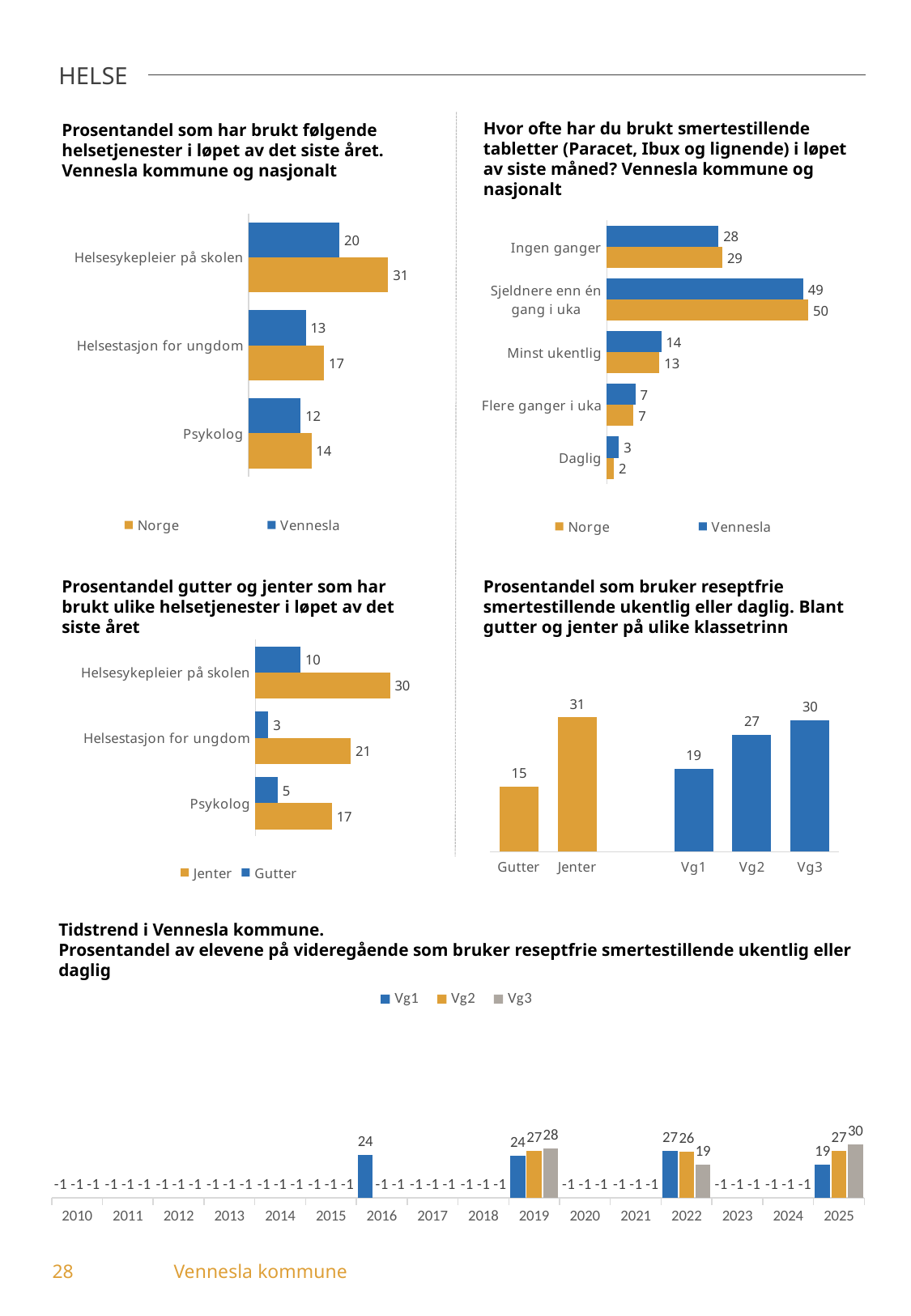
In the chart 'Prosentandel gutter og jenter som har brukt ulike helsetjenester', what is the value for Gutter for Helsestasjon for ungdom? 3 In the chart 'Prosentandel som har brukt følgende helsetjenester i løpet av det siste året', what is the value for Norge for Helsesykepleier på skolen? 31 In the chart 'Hvor ofte har du brukt smertestillende tabletter', how many categories are shown? 5 In the chart 'Prosentandel som har brukt følgende helsetjenester i løpet av det siste året', what is the difference between the Norge and Vennesla values for Helsestasjon for ungdom? 4 In the chart 'Tidstrend i Vennesla kommune', how many series does the legend list? 3 In the chart 'Prosentandel som bruker reseptfrie smertestillende ukentlig eller daglig', which category has the lowest value? Gutter In the chart 'Hvor ofte har du brukt smertestillende tabletter', what is the Norge value for Daglig? 2 In the chart 'Prosentandel gutter og jenter som har brukt ulike helsetjenester', which is larger for Psykolog: Jenter or Gutter? Jenter In the chart 'Prosentandel som bruker reseptfrie smertestillende ukentlig eller daglig', what is the value for Vg2? 27 In the chart 'Hvor ofte har du brukt smertestillende tabletter', which category has the highest value for Vennesla? Sjeldnere enn én gang i uka What kind of chart is 'Prosentandel som bruker reseptfrie smertestillende ukentlig eller daglig'? Bar chart In the chart 'Tidstrend i Vennesla kommune', what is the Vg3 value for 2025? 30